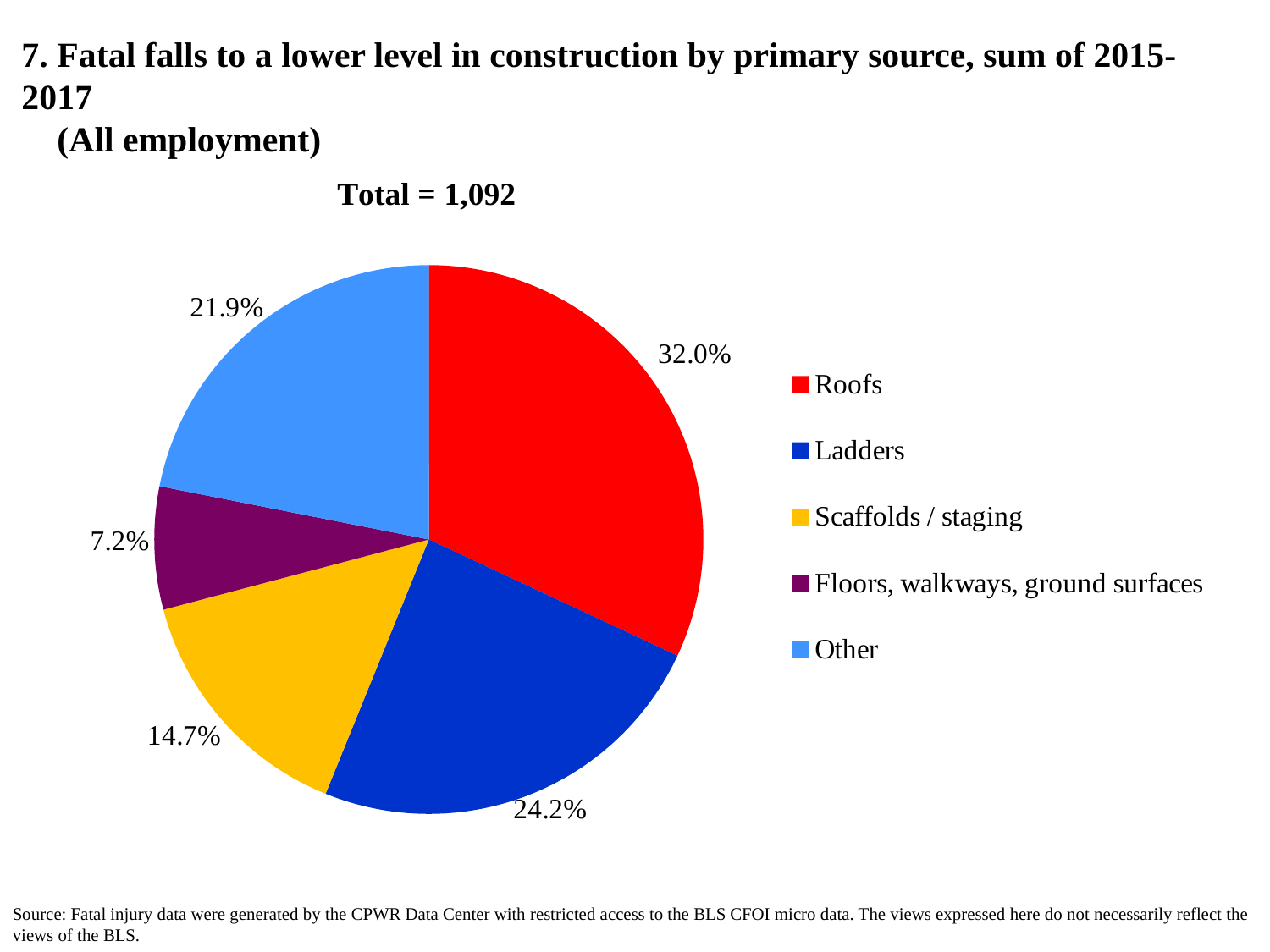
Which has a larger share, Scaffolds / staging or Other? Other What share of fatal falls to a lower level is attributed to Other? 21.9% What share of fatal falls to a lower level is attributed to Ladders? 24.2% Which primary source accounts for the largest share of fatal falls to a lower level? Roofs What type of chart is shown on the slide? Pie chart What share of fatal falls to a lower level is attributed to Scaffolds / staging? 14.7% How many percentage points larger is the Roofs share than the Ladders share? 7.8 Which primary source accounts for the smallest share of fatal falls to a lower level? Floors, walkways, ground surfaces What total number of fatal falls is stated above the chart? 1,092 How many categories does the pie chart show? 5